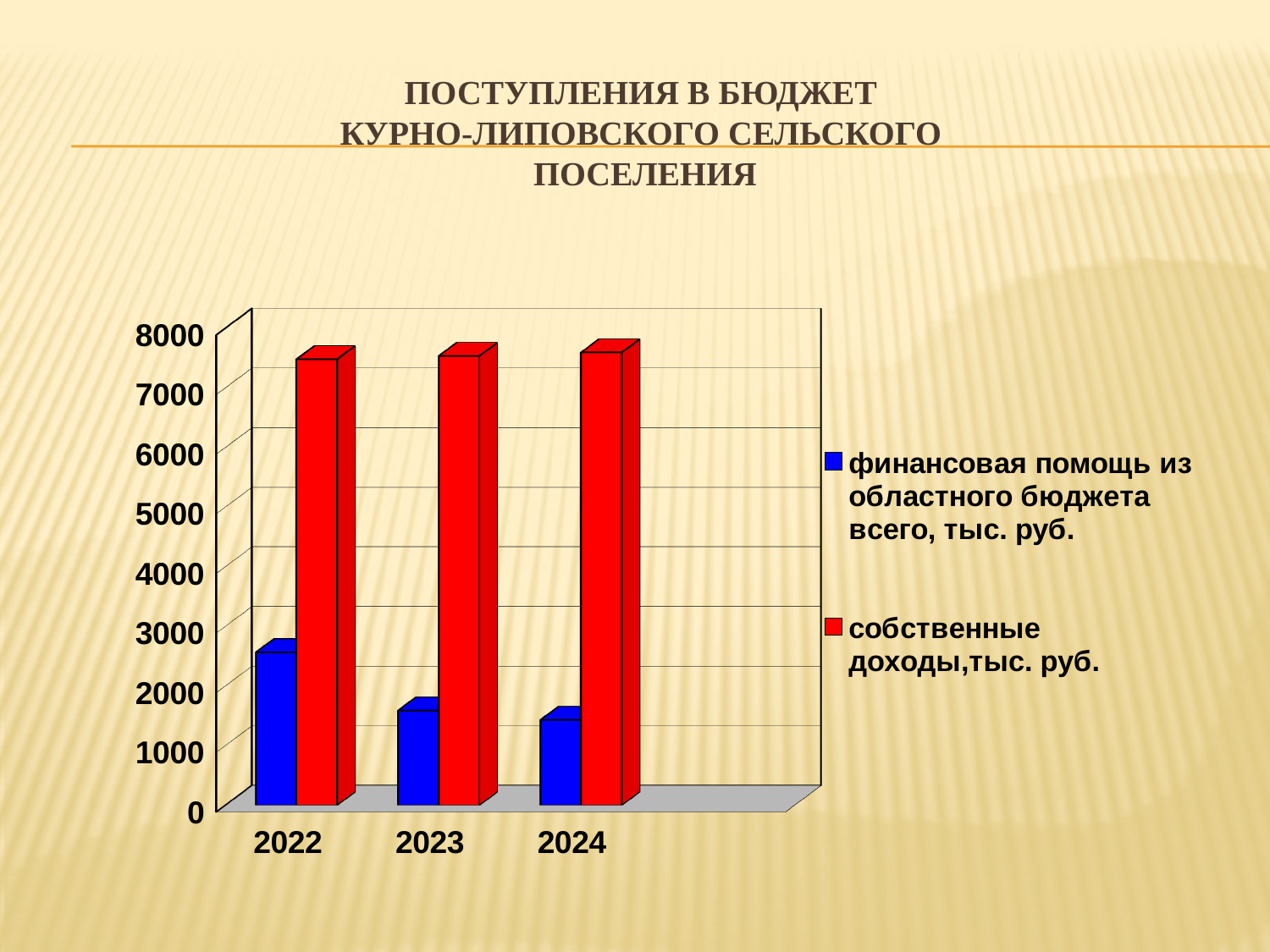
How many years are shown on the x axis of the chart? 3 Is the value for финансовая помощь из областного бюджета in 2024 greater or less than 2000? less In 2023, which is larger: финансовая помощь из областного бюджета or собственные доходы? собственные доходы Is the value for собственные доходы in 2024 greater or less than 8000? less Which year has the highest value for финансовая помощь из областного бюджета? 2022 Is the value for собственные доходы in 2022 greater or less than 7000? greater How many series does the legend list? 2 What kind of chart is shown on the slide? bar chart Which colour represents собственные доходы in the chart? red Do the values for финансовая помощь из областного бюджета rise or fall from 2022 to 2024? fall